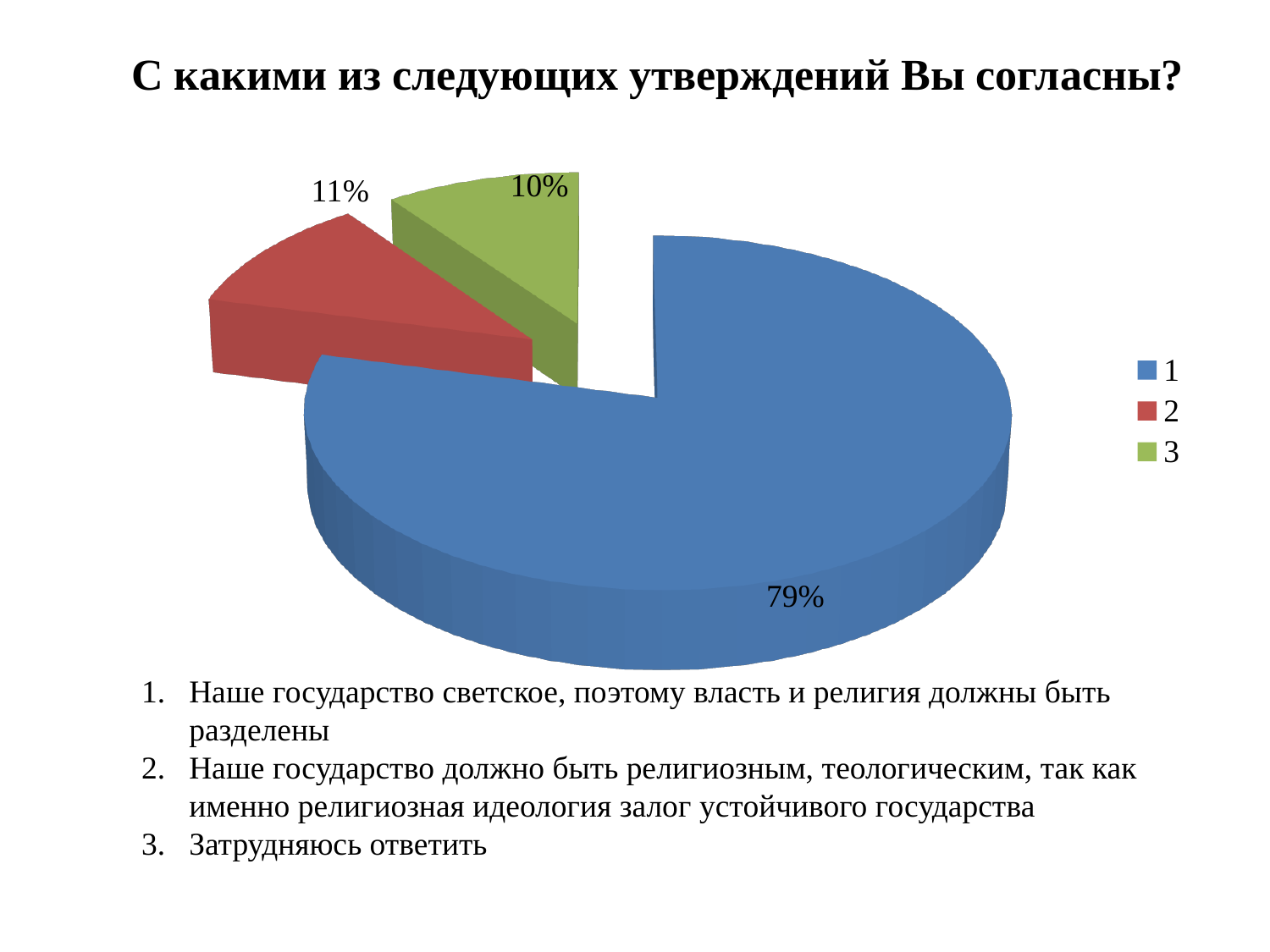
How many slices does the pie chart have? 3 What is the difference in percentage points between category 2 and category 3? 1 Which category has the smallest slice of the pie? 3 Which category has the largest slice of the pie? 1 What is the difference in percentage points between category 1 and category 2? 68 What share of the pie does category 1 have? 79% What share of the pie does category 3 have? 10% What kind of chart is shown on the slide? pie chart What colour is the slice for category 2? red What share of the pie does category 2 have? 11% How many entries does the legend list? 3 Which is larger, the slice for category 1 or the slice for category 3? 1